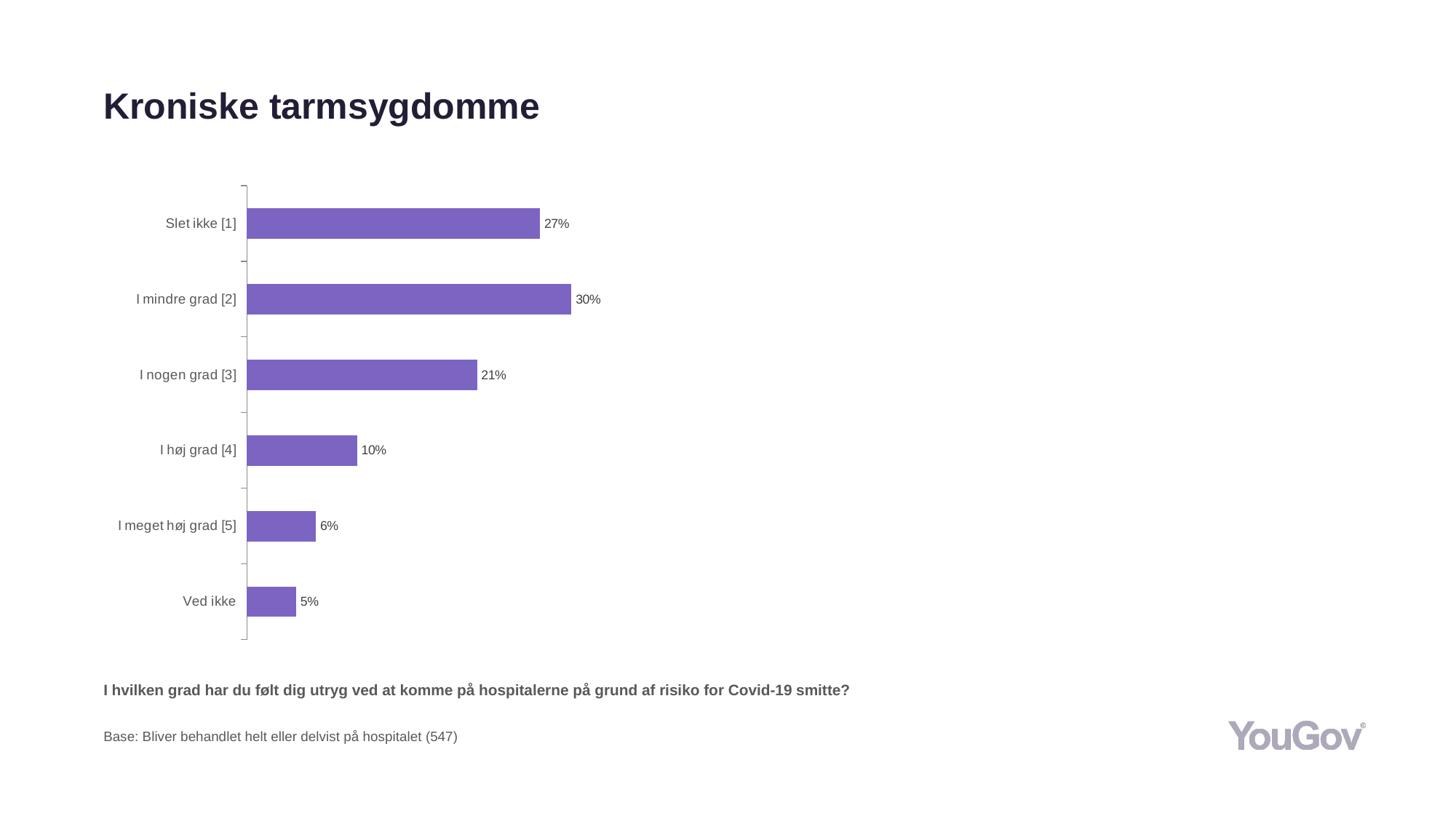
Which is larger, the value for "I høj grad [4]" or the value for "I meget høj grad [5]"? I høj grad [4] What is the value for "I nogen grad [3]"? 21% What is the title of the slide? Kroniske tarmsygdomme What kind of chart is shown on the slide? Bar chart What is the difference between the values for "I mindre grad [2]" and "Slet ikke [1]"? 3% What is the value for "Slet ikke [1]"? 27% What is the difference between the values for "I nogen grad [3]" and "I høj grad [4]"? 11% What is the value for "I meget høj grad [5]"? 6% How many categories are shown in the chart? 6 Which category has the lowest value? Ved ikke Which category has the highest value? I mindre grad [2] What is the value for "I mindre grad [2]"? 30%